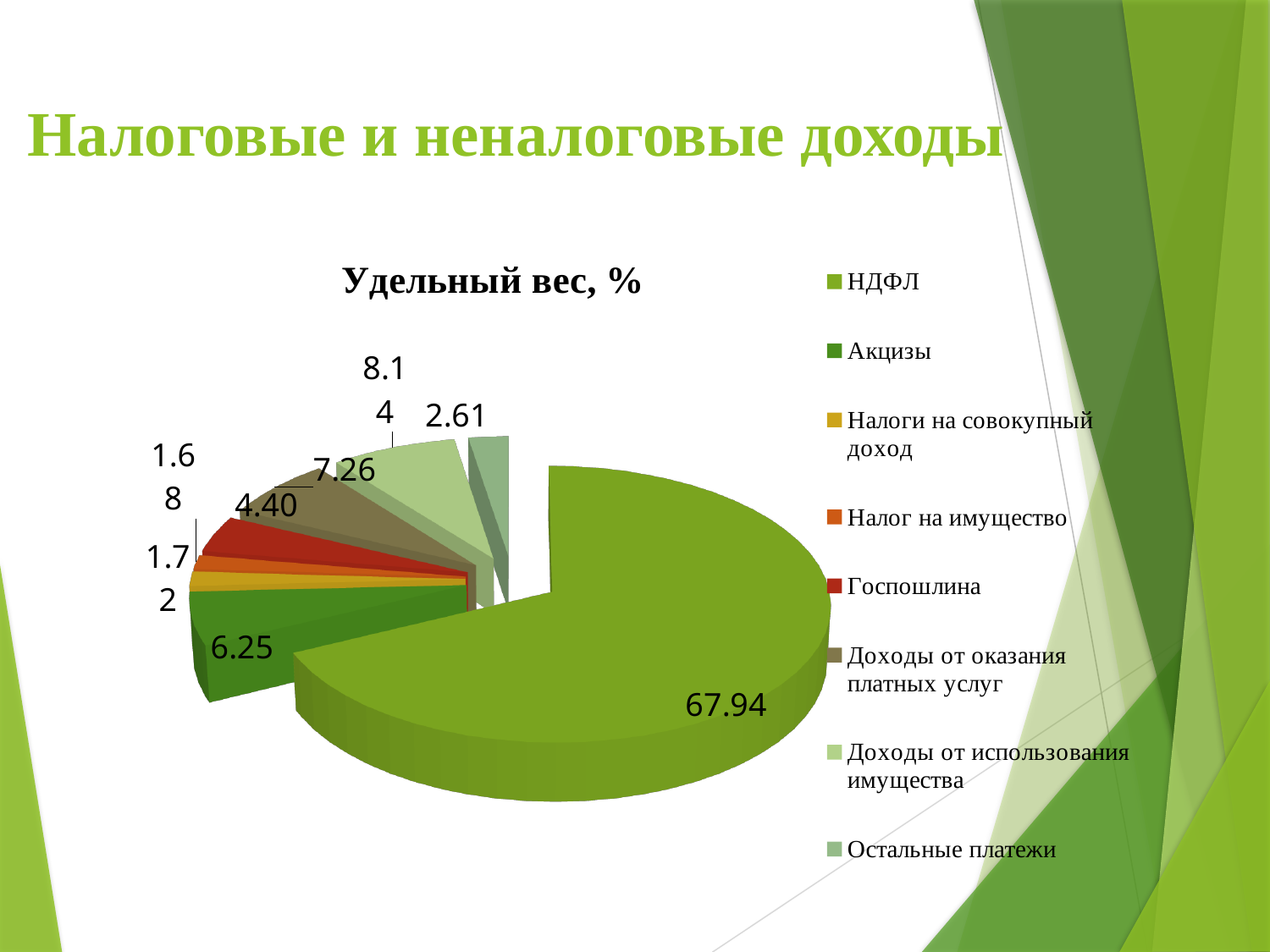
What is the value for Остальные платежи? 2.61 Which category has the largest slice of the pie? НДФЛ What is the value for Доходы от использования имущества? 8.14 What is the title of the chart? Удельный вес, % What is the value for НДФЛ? 67.94 Which is larger, the value for Акцизы or the value for Госпошлина? Акцизы What is the value for Доходы от оказания платных услуг? 7.26 What kind of chart is shown on the slide? pie chart How many categories does the pie chart show? 8 What is the value for Акцизы? 6.25 What is the difference between the values for НДФЛ and Акцизы? 61.69 What is the value for Госпошлина? 4.40